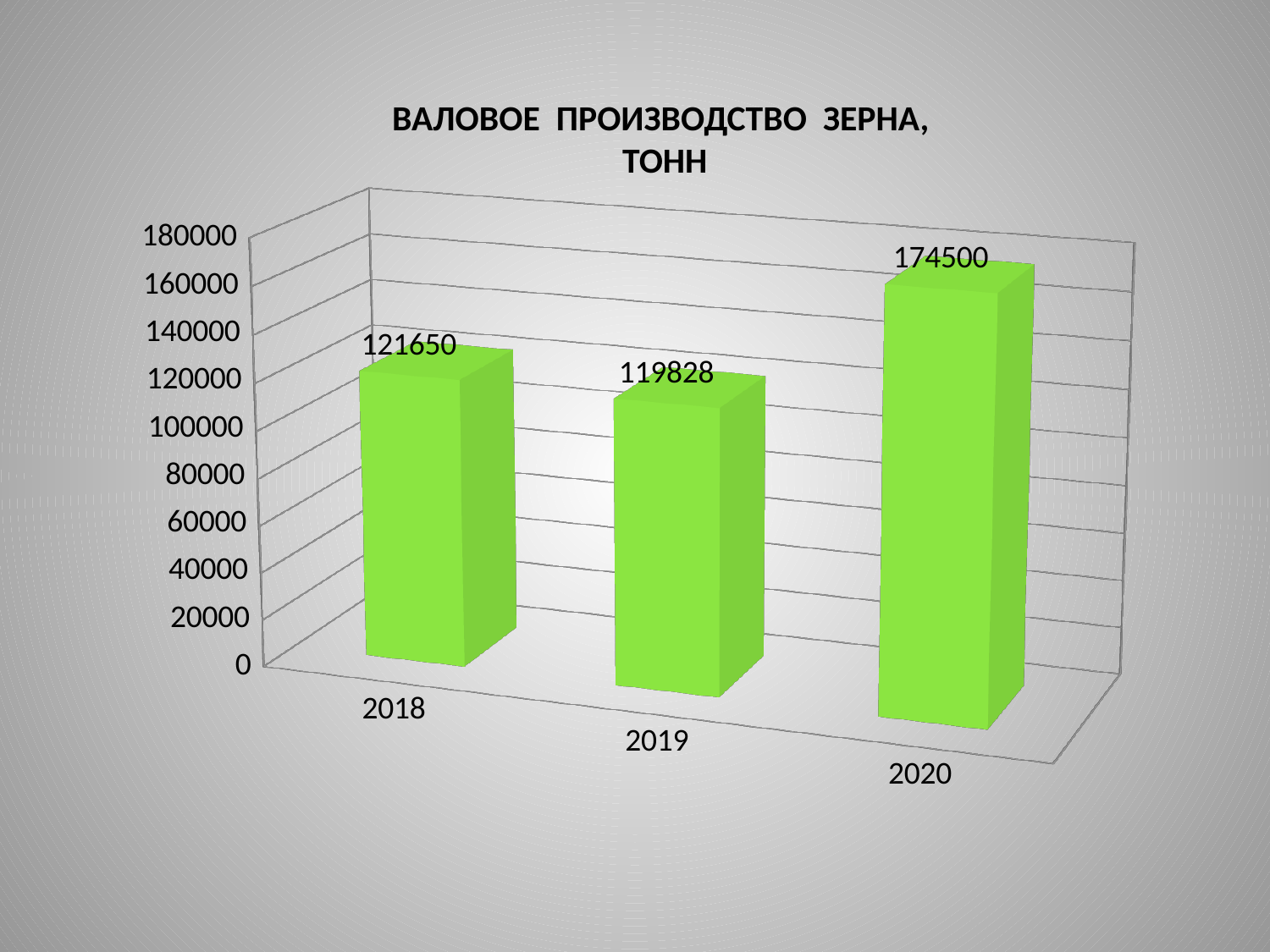
What is the difference between the 2018 and 2019 values? 1822 Is the value for 2020 greater or less than 160000? greater What is the gross grain production value for 2018? 121650 Which is larger, the value for 2020 or the value for 2019? 2020 What kind of chart is shown on the slide? bar chart Which year has the lowest gross grain production? 2019 What is the title of the chart? ВАЛОВОЕ ПРОИЗВОДСТВО ЗЕРНА, ТОНН What is the gross grain production value for 2019? 119828 Which year has the highest gross grain production? 2020 How many years are shown on the chart? 3 What is the gross grain production value for 2020? 174500 What is the difference between the 2020 and 2018 values? 52850